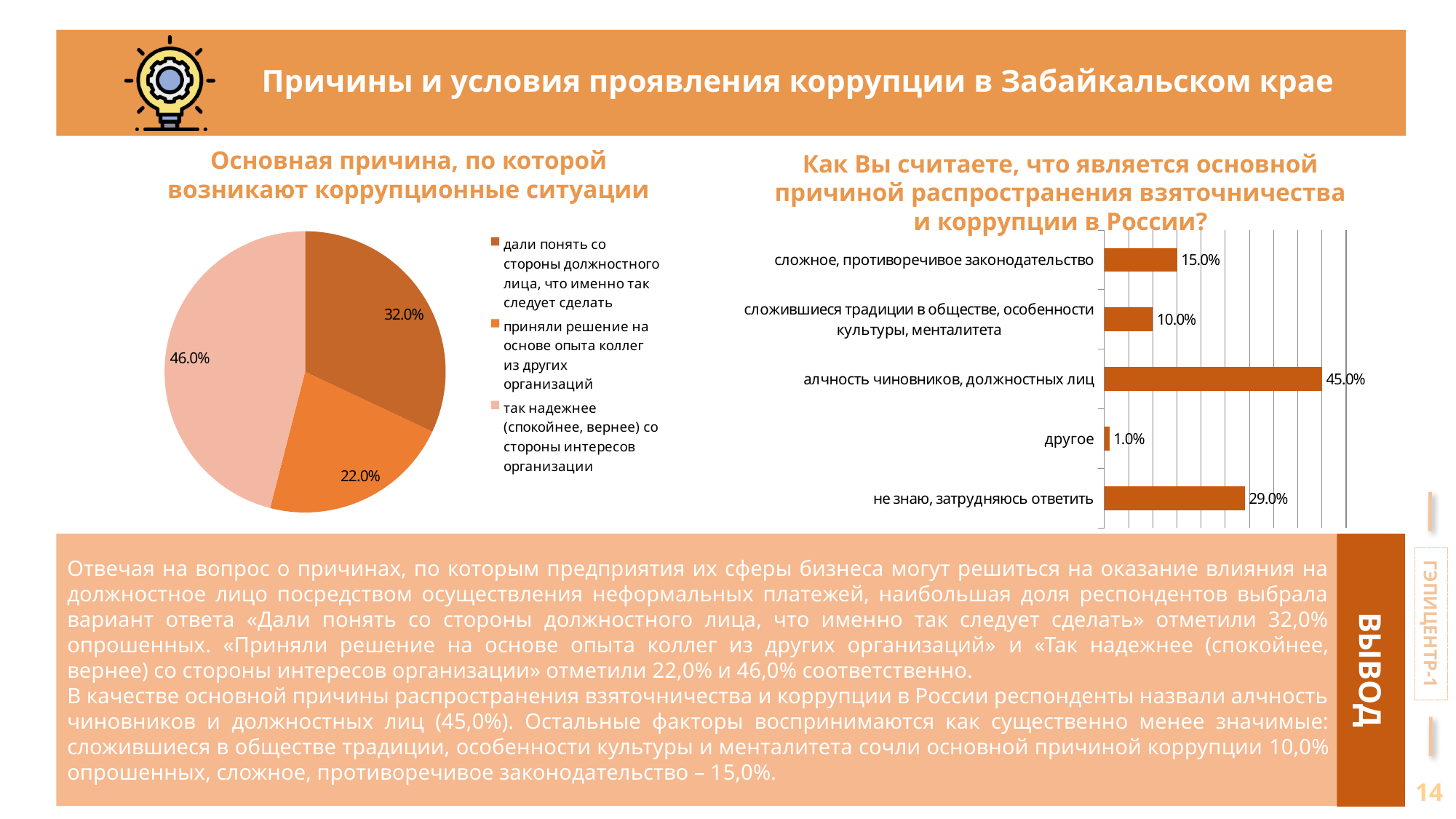
In the bar chart on the right, how many categories are shown? 5 In the pie chart on the left, what is the value for 'приняли решение на основе опыта коллег из других организаций'? 22.0% What type of chart is the chart on the right side of the slide? Bar chart In the pie chart on the left, which is larger: 'дали понять со стороны должностного лица, что именно так следует сделать' or 'приняли решение на основе опыта коллег из других организаций'? дали понять со стороны должностного лица, что именно так следует сделать What type of chart is the chart on the left side of the slide? Pie chart In the bar chart on the right, what is the value for 'сложное, противоречивое законодательство'? 15.0% In the pie chart 'Основная причина, по которой возникают коррупционные ситуации', what share does 'так надежнее (спокойнее, вернее) со стороны интересов организации' have? 46.0% In the bar chart on the right, which category has the lowest value? другое In the bar chart on the right, what is the difference between the values for 'алчность чиновников, должностных лиц' and 'не знаю, затрудняюсь ответить'? 16.0% How many entries does the legend of the pie chart on the left list? 3 In the bar chart 'Как Вы считаете, что является основной причиной распространения взяточничества и коррупции в России?', what is the value for 'алчность чиновников, должностных лиц'? 45.0% In the bar chart on the right, which category has the highest value? алчность чиновников, должностных лиц